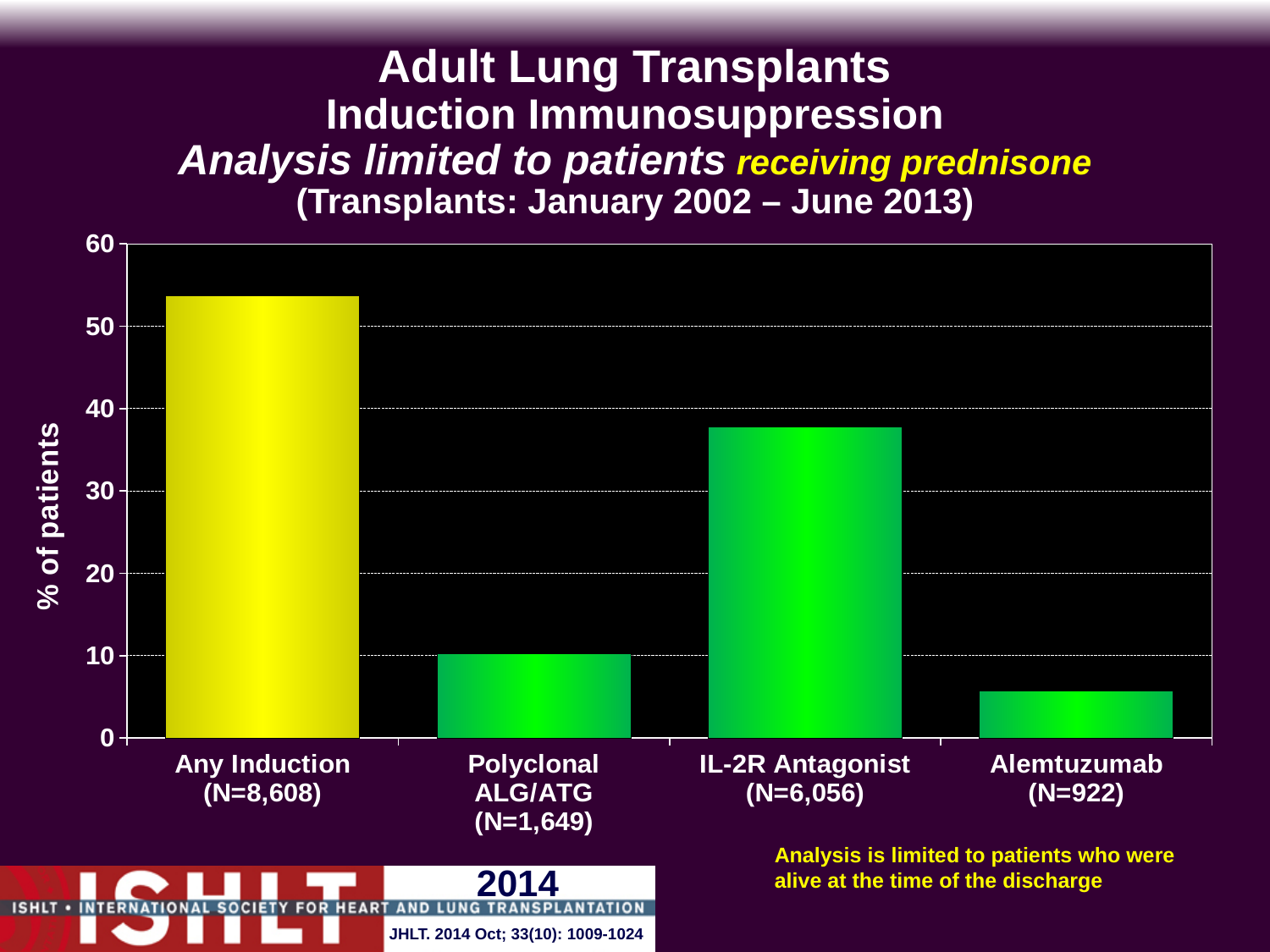
Which category has the lowest percentage of patients? Alemtuzumab What is the label of the y axis? % of patients Is the value for IL-2R Antagonist greater or less than 40? less How many categories are plotted on the chart? 4 Is the value for Any Induction greater or less than 50? greater Which category has the highest percentage of patients? Any Induction What kind of chart is shown on the slide? bar chart Which is larger, the value for IL-2R Antagonist or the value for Polyclonal ALG/ATG? IL-2R Antagonist Is the value for Polyclonal ALG/ATG greater or less than 20? less What is the N shown for the IL-2R Antagonist category? N=6,056